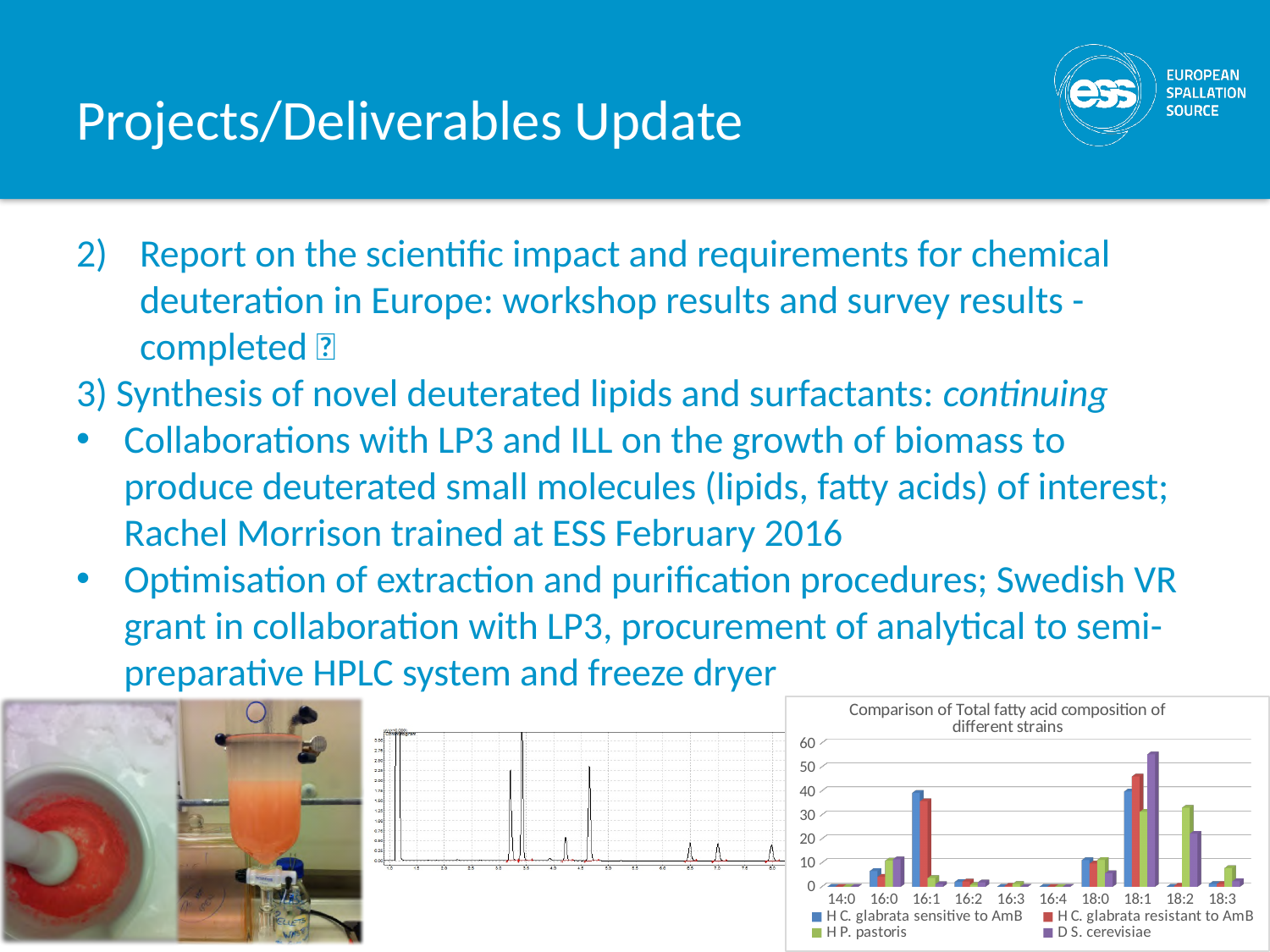
In the bar chart, at 18:1, which is larger: H C. glabrata sensitive to AmB or H C. glabrata resistant to AmB? H C. glabrata resistant to AmB In the bar chart, which fatty acid category has the highest value for H C. glabrata resistant to AmB? 18:1 What is the title of the bar chart on the slide? Comparison of Total fatty acid composition of different strains In the bar chart, is the value for H P. pastoris at 18:2 greater or less than 20? greater How many series does the legend of the bar chart list? 4 In the bar chart, is the value for D S. cerevisiae at 18:1 greater or less than 50? greater In the bar chart, is the value for H C. glabrata sensitive to AmB at 16:1 greater or less than 30? greater What colour represents D S. cerevisiae in the bar chart legend? purple In the bar chart, which fatty acid category has the highest value for D S. cerevisiae? 18:1 What kind of chart is shown at the bottom right of the slide? bar chart In the bar chart, at 16:1, which is larger: H C. glabrata sensitive to AmB or H P. pastoris? H C. glabrata sensitive to AmB How many fatty acid categories are shown on the x axis of the bar chart? 10